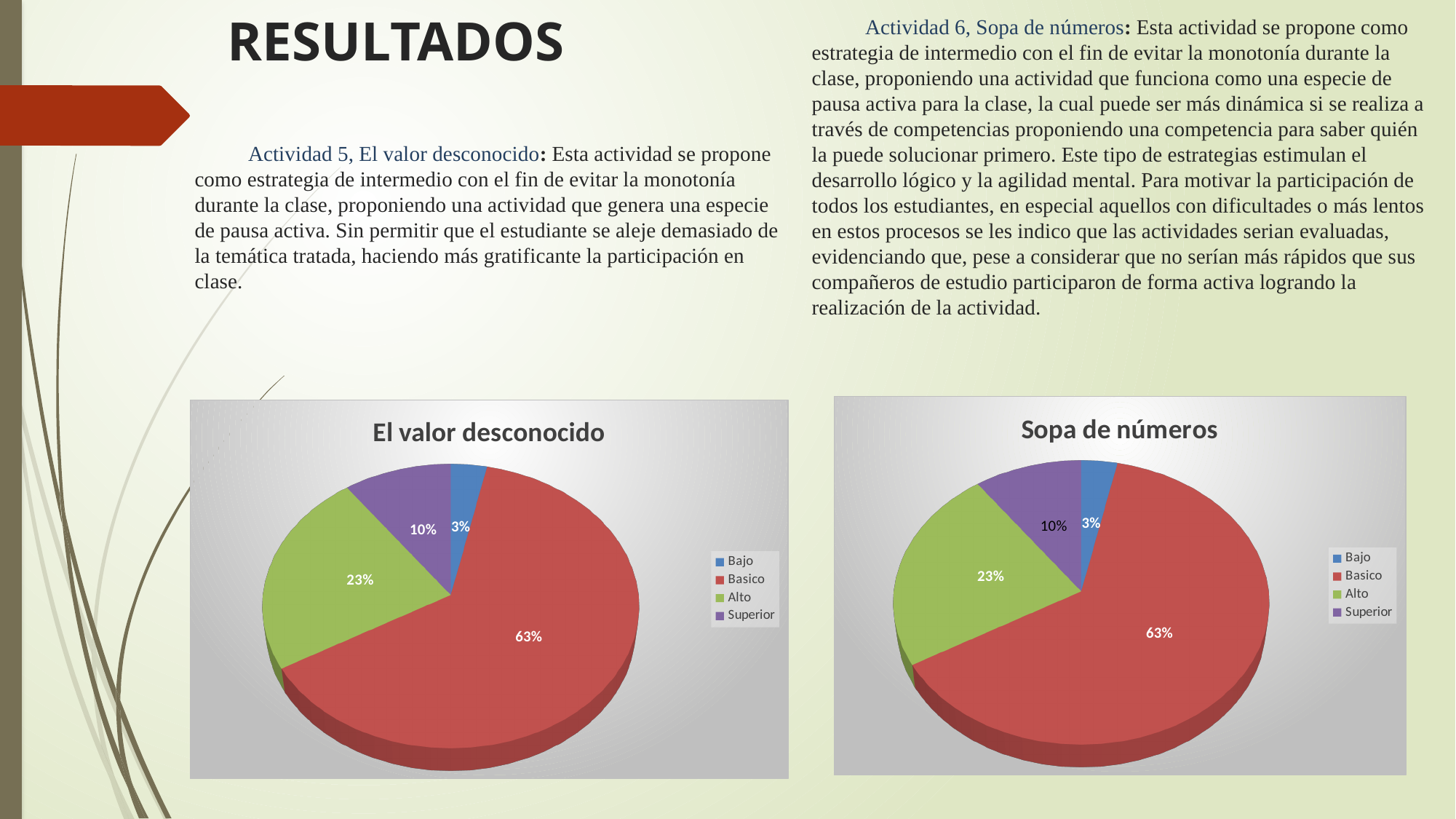
In the 'El valor desconocido' chart, which category has the largest share? Basico In the 'El valor desconocido' chart, what colour represents Alto in the legend? Green In the 'El valor desconocido' chart, what is the difference between the Basico and Alto percentages? 40% In the 'Sopa de números' chart, what percentage is shown for Bajo? 3% In the 'El valor desconocido' chart, what percentage is shown for Basico? 63% In the 'Sopa de números' chart, which category has the smallest share? Bajo In the 'El valor desconocido' chart, what percentage is shown for Superior? 10% In the 'Sopa de números' chart, which is larger, Alto or Superior? Alto In the 'Sopa de números' chart, what percentage is shown for Alto? 23% What is the title of the chart on the right side of the slide? Sopa de números How many categories does the 'Sopa de números' pie chart show? 4 What type of chart is 'El valor desconocido'? Pie chart